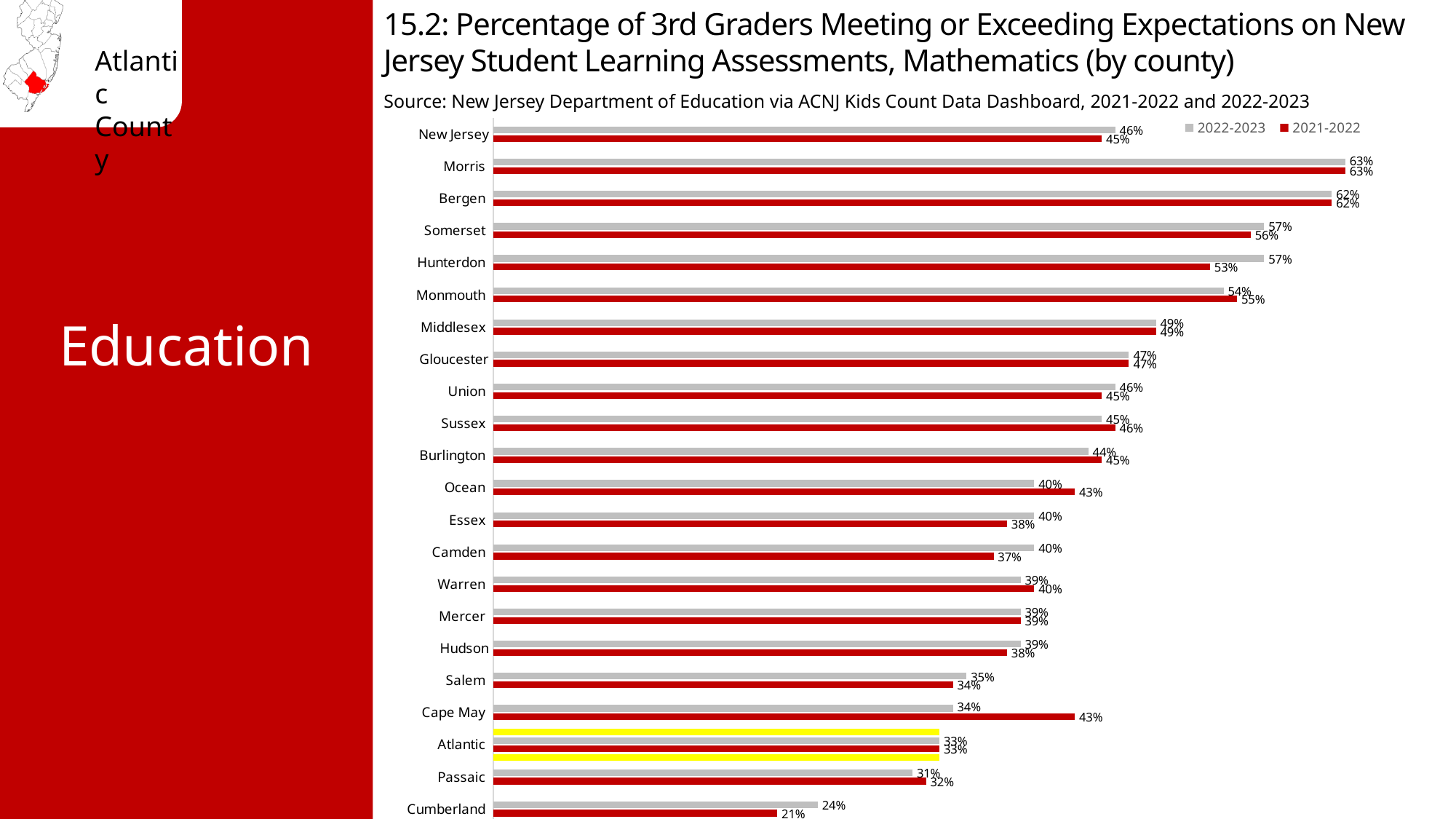
What is the 2022-2023 value for Atlantic? 33% What is the difference between the 2021-2022 and 2022-2023 values for Cape May? 9% How many categories (counties plus New Jersey) are shown on the chart? 22 How many series does the legend list? 2 What is the 2022-2023 value for Hunterdon? 57% What is the 2021-2022 value for Cumberland? 21% What is the 2021-2022 value for Cape May? 43% Which is larger for Hunterdon: the 2022-2023 value or the 2021-2022 value? 2022-2023 Which county has the highest 2022-2023 value? Morris Which county's bars are highlighted in yellow on the chart? Atlantic Which county has the lowest 2021-2022 value? Cumberland What kind of chart is shown on the slide? Bar chart